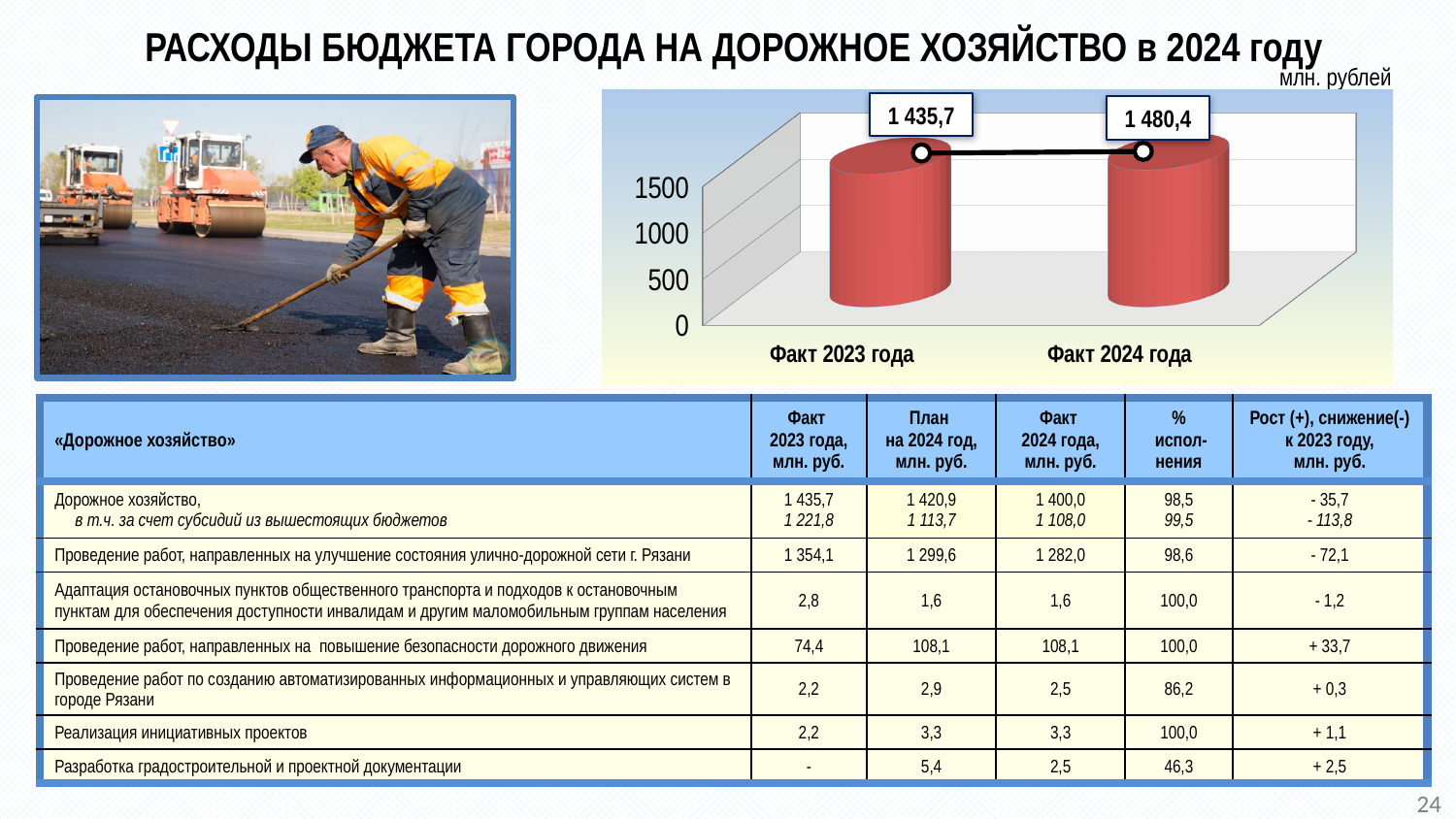
Which category has the lowest value on the chart? Факт 2023 года How many categories are plotted on the chart? 2 What is the highest tick value shown on the chart's vertical axis? 1500 Which category has the higher value on the chart, Факт 2023 года or Факт 2024 года? Факт 2024 года Do the values rise or fall from Факт 2023 года to Факт 2024 года? rise What value is shown for Факт 2024 года on the chart? 1 480,4 What kind of chart is shown on the slide? bar chart Which category has the highest value on the chart? Факт 2024 года What unit of measurement is indicated for the chart? млн. рублей Is the value for Факт 2023 года greater or less than 1000? greater What is the difference between the values for Факт 2024 года and Факт 2023 года on the chart? 44,7 What value is shown for Факт 2023 года on the chart? 1 435,7